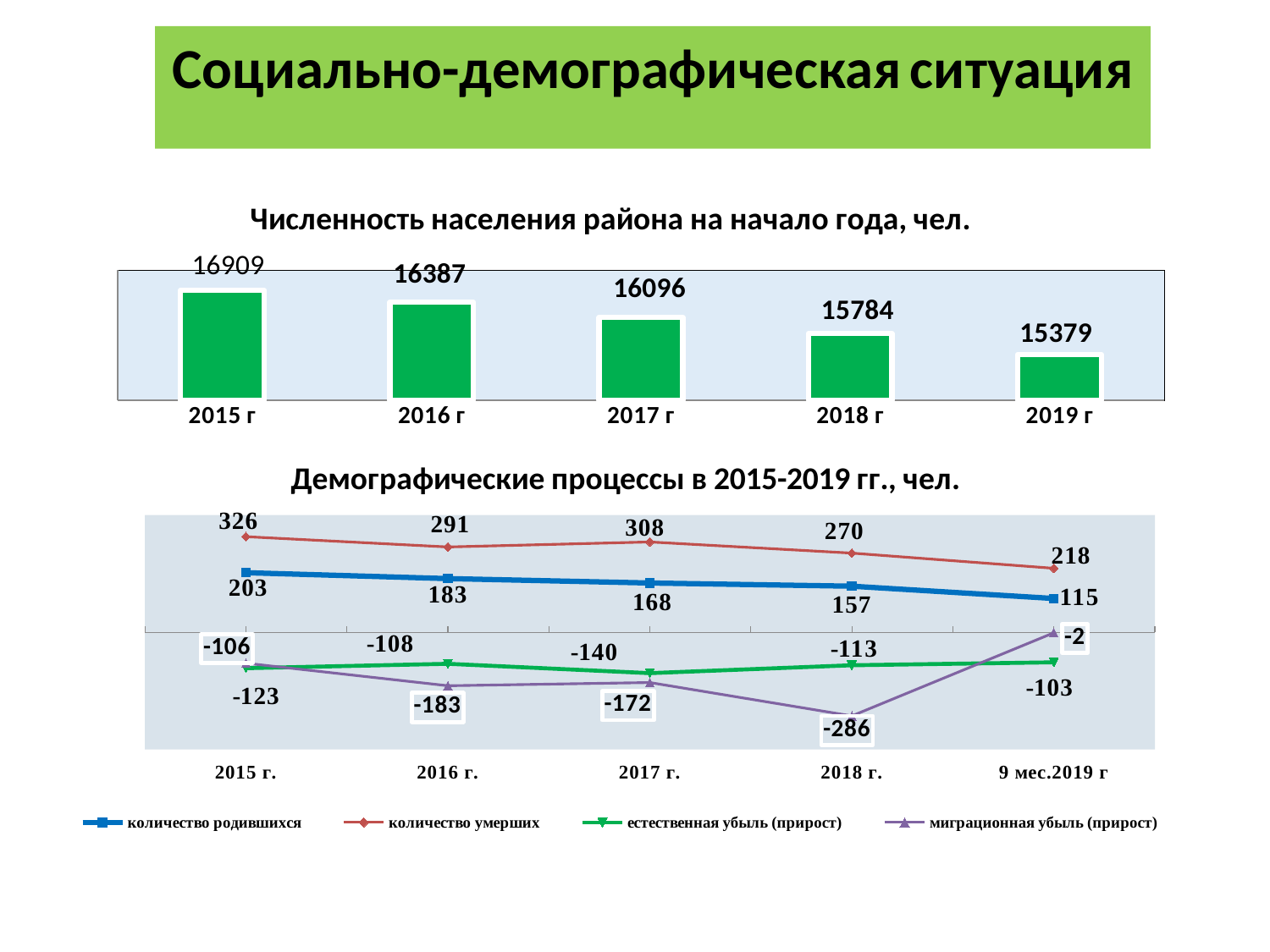
In the chart 'Численность населения района на начало года, чел.', which year has the lowest value? 2019 г In the chart 'Демографические процессы в 2015-2019 гг., чел.', in which year is 'количество родившихся' highest? 2015 г. In the chart 'Численность населения района на начало года, чел.', do the values rise or fall from 2015 г to 2019 г? fall What kind of chart is 'Демографические процессы в 2015-2019 гг., чел.'? line chart In the chart 'Численность населения района на начало года, чел.', what is the value for 2017 г? 16096 What kind of chart is 'Численность населения района на начало года, чел.'? bar chart In the chart 'Демографические процессы в 2015-2019 гг., чел.', what is the value of 'количество умерших' for 2017 г.? 308 In the chart 'Численность населения района на начало года, чел.', what is the difference between the values for 2015 г and 2019 г? 1530 How many series does the legend of the chart 'Демографические процессы в 2015-2019 гг., чел.' list? 4 In the chart 'Демографические процессы в 2015-2019 гг., чел.', which is larger in 2015 г.: 'количество умерших' or 'количество родившихся'? количество умерших In the chart 'Демографические процессы в 2015-2019 гг., чел.', what is the value of 'миграционная убыль (прирост)' for 2018 г.? -286 In the chart 'Демографические процессы в 2015-2019 гг., чел.', what is the difference between 'количество умерших' and 'количество родившихся' in 2016 г.? 108